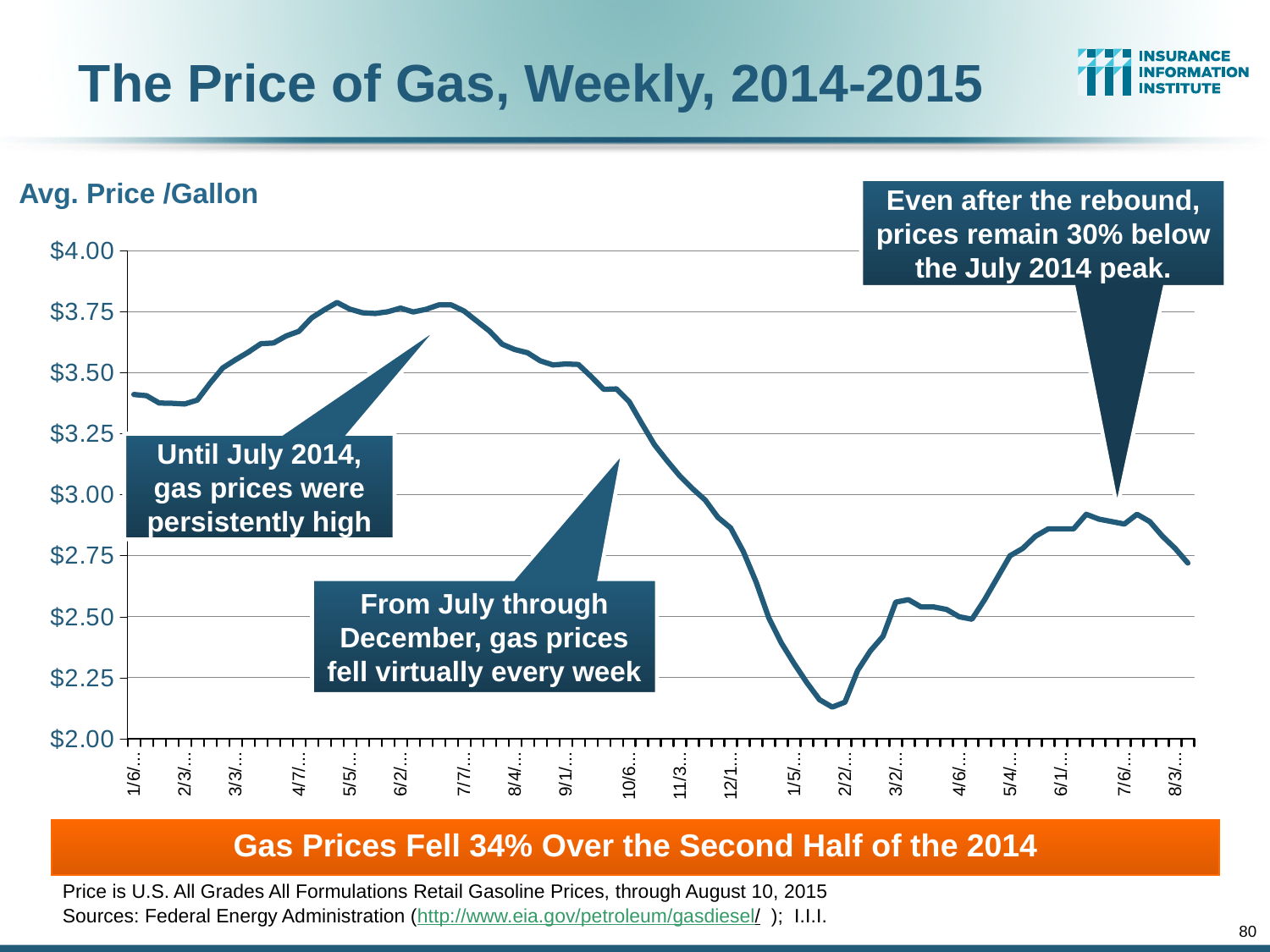
Is the value at the 6/1 tick greater or less than $3.00? less What kind of chart is shown on the slide? line chart Is the value at the 2/2 tick greater or less than $2.50? less What is the title of the chart on the slide? The Price of Gas, Weekly, 2014-2015 Is the value at the 7/7 tick greater or less than $3.50? greater Do gas prices rise or fall between the 2/2 tick and the 6/1 tick? rise Do gas prices rise or fall between the 7/7 tick and the 2/2 tick? fall Which is higher, the value at the 1/6 tick or the value at the 8/3 tick? 1/6 What label is shown above the vertical axis of the chart? Avg. Price /Gallon